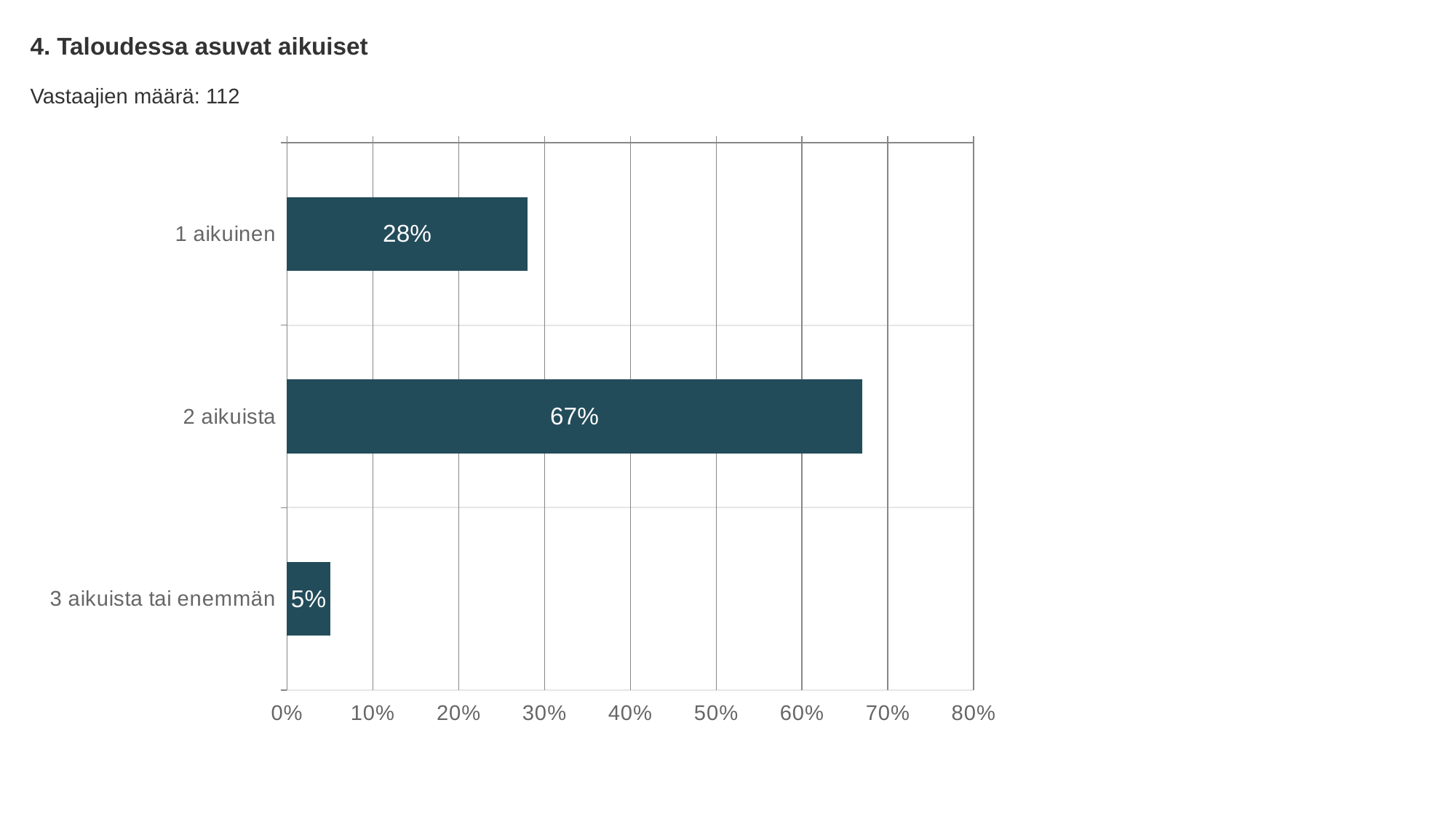
What is the value for "2 aikuista"? 67% How many categories are shown in the chart? 3 What is the value for "3 aikuista tai enemmän"? 5% Is the value for "1 aikuinen" greater or less than 30%? less What is the difference between the values for "2 aikuista" and "1 aikuinen"? 39% Which is larger, the value for "1 aikuinen" or the value for "3 aikuista tai enemmän"? 1 aikuinen What is the title of the chart? 4. Taloudessa asuvat aikuiset What kind of chart is shown on the slide? bar chart What is the value for "1 aikuinen"? 28% Which category has the lowest value? 3 aikuista tai enemmän Which category has the highest value? 2 aikuista Is the value for "2 aikuista" greater or less than 60%? greater